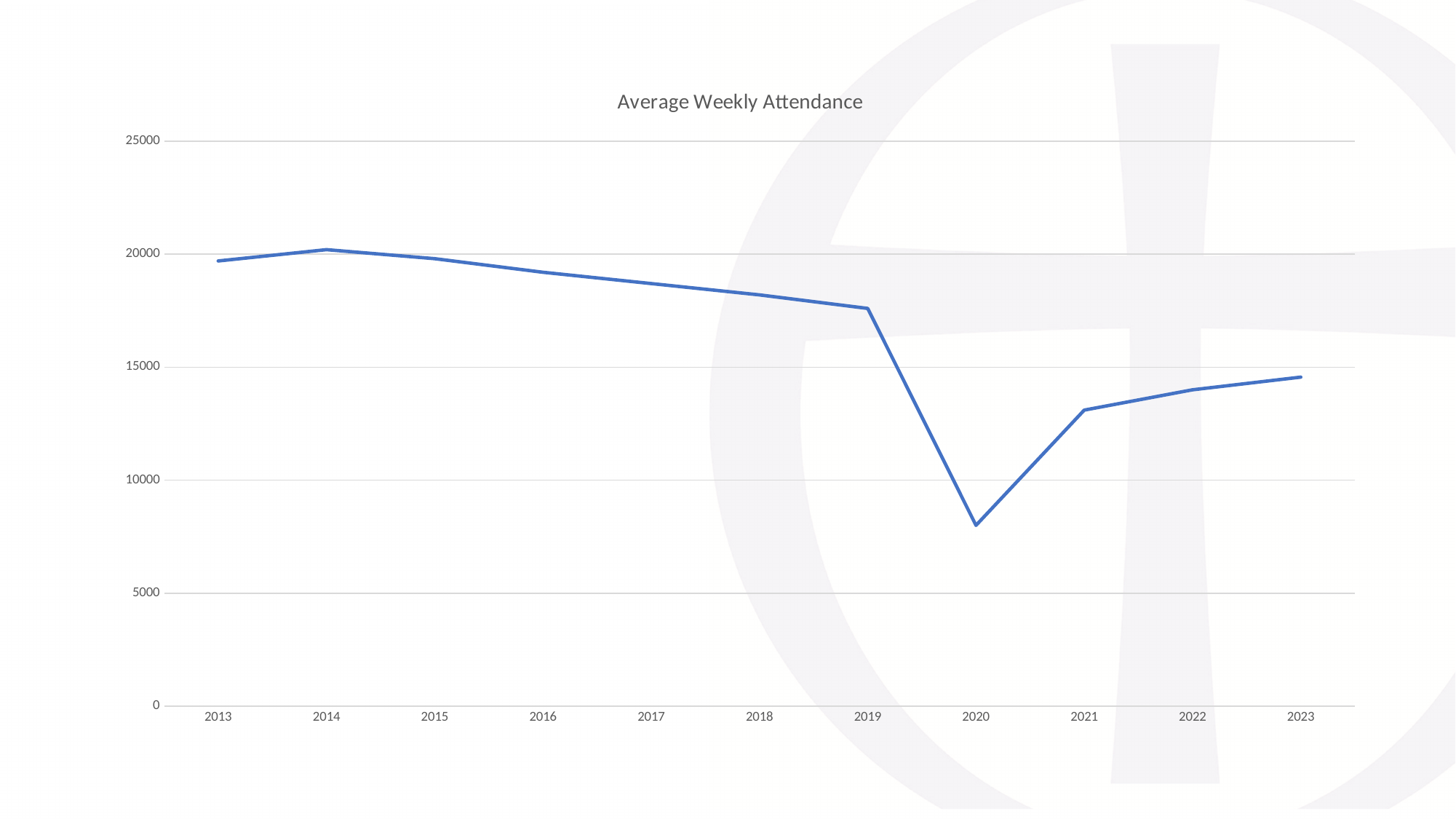
Is the value for 2019 greater or less than 15000? greater What kind of chart is shown on the slide? line chart Does the average weekly attendance rise or fall from 2020 to 2023? rise Which year has the highest average weekly attendance? 2014 Is the value for 2020 greater or less than 10000? less How many years are plotted on the x axis? 11 Does the average weekly attendance rise or fall from 2014 to 2019? fall Which year has the higher average weekly attendance, 2013 or 2021? 2013 What is the title of the chart? Average Weekly Attendance Is the value for 2023 greater or less than 15000? less Which year has the lowest average weekly attendance? 2020